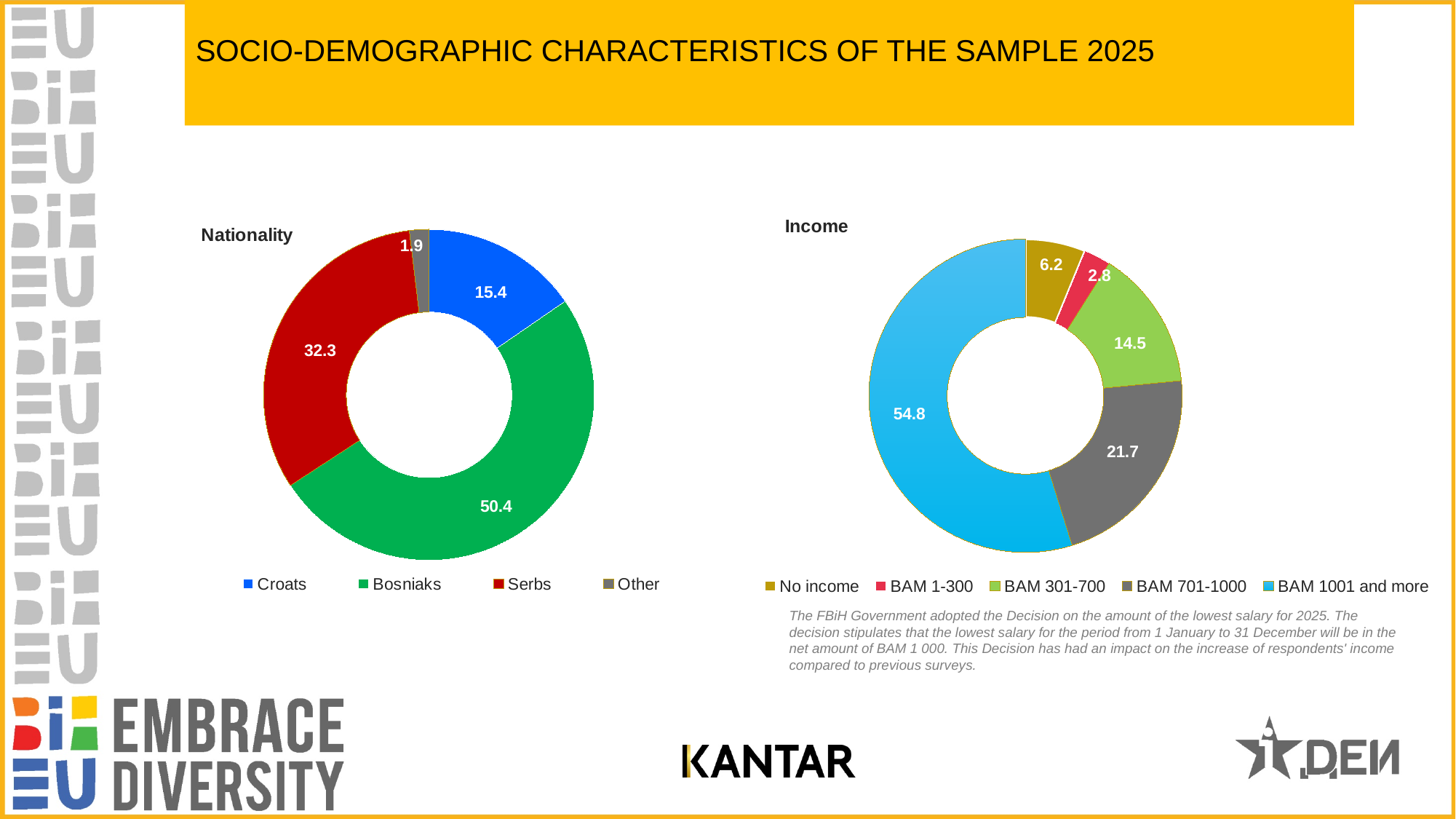
In the Nationality chart, what is the value for Serbs? 32.3 In the Income chart, what is the value for BAM 301-700? 14.5 In the Income chart, which category has the smallest share? BAM 1-300 What type of chart is the Nationality chart? Doughnut chart In the Nationality chart, what is the value for Bosniaks? 50.4 In the Nationality chart, which category has the smallest share? Other In the Income chart, which is larger: No income or BAM 701-1000? BAM 701-1000 In the Income chart, which category has the largest share? BAM 1001 and more In the Nationality chart, how many categories are shown? 4 In the Nationality chart, what is the difference between the values for Serbs and Croats? 16.9 In the Income chart, how many categories does the legend list? 5 In the Income chart, what is the value for BAM 1001 and more? 54.8